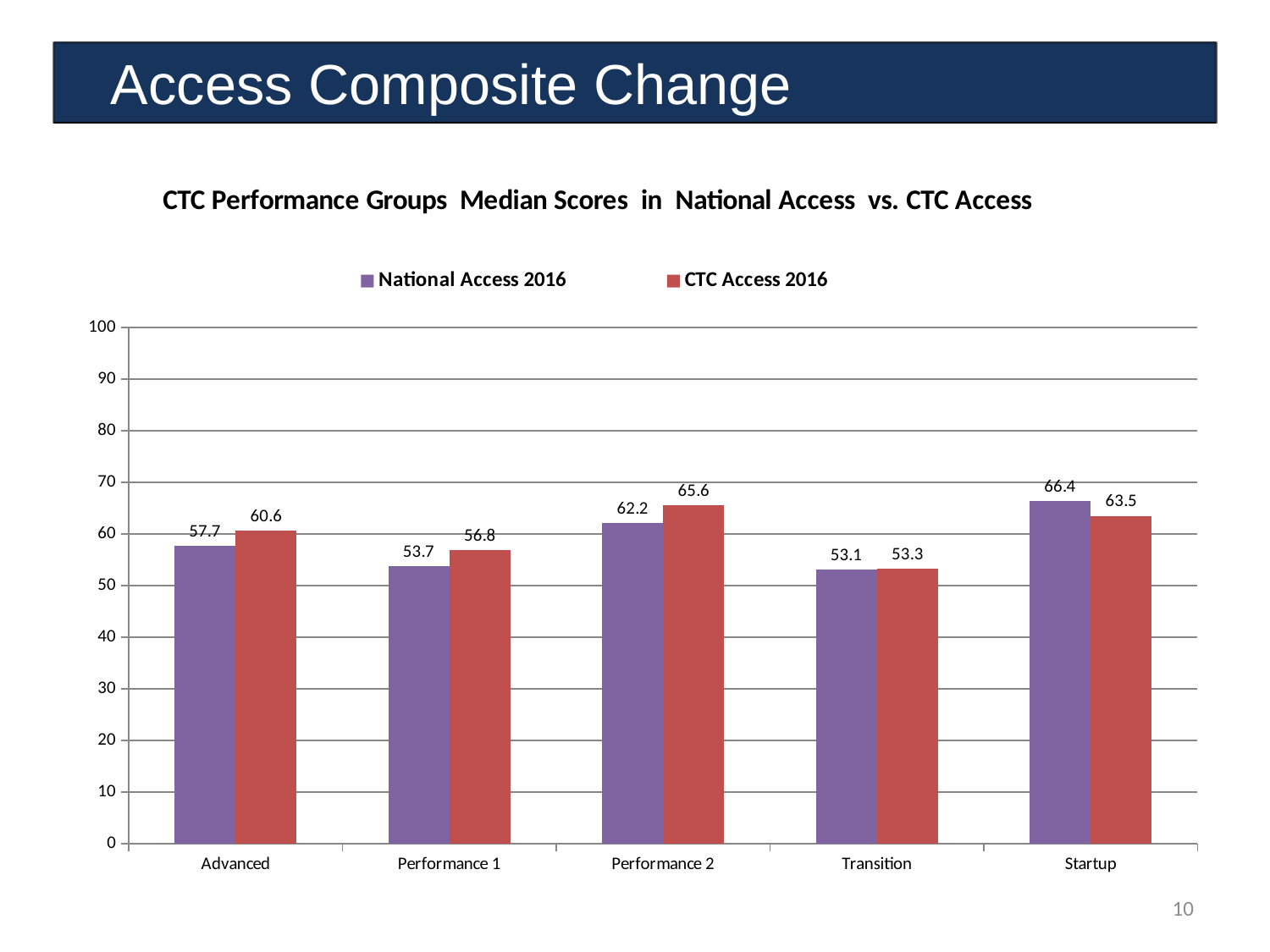
What is the difference between the CTC Access 2016 and National Access 2016 values for Performance 1? 3.1 How many categories are shown on the x axis? 5 Which is larger for Startup: National Access 2016 or CTC Access 2016? National Access 2016 How many series does the legend list? 2 Which category has the lowest CTC Access 2016 value? Transition What is the CTC Access 2016 value for Performance 2? 65.6 Which category has the highest National Access 2016 value? Startup What is the CTC Access 2016 value for Transition? 53.3 What kind of chart is shown on the slide? bar chart What is the title of the chart? CTC Performance Groups Median Scores in National Access vs. CTC Access What is the National Access 2016 value for Advanced? 57.7 Is the CTC Access 2016 value for Advanced greater or less than 70? less